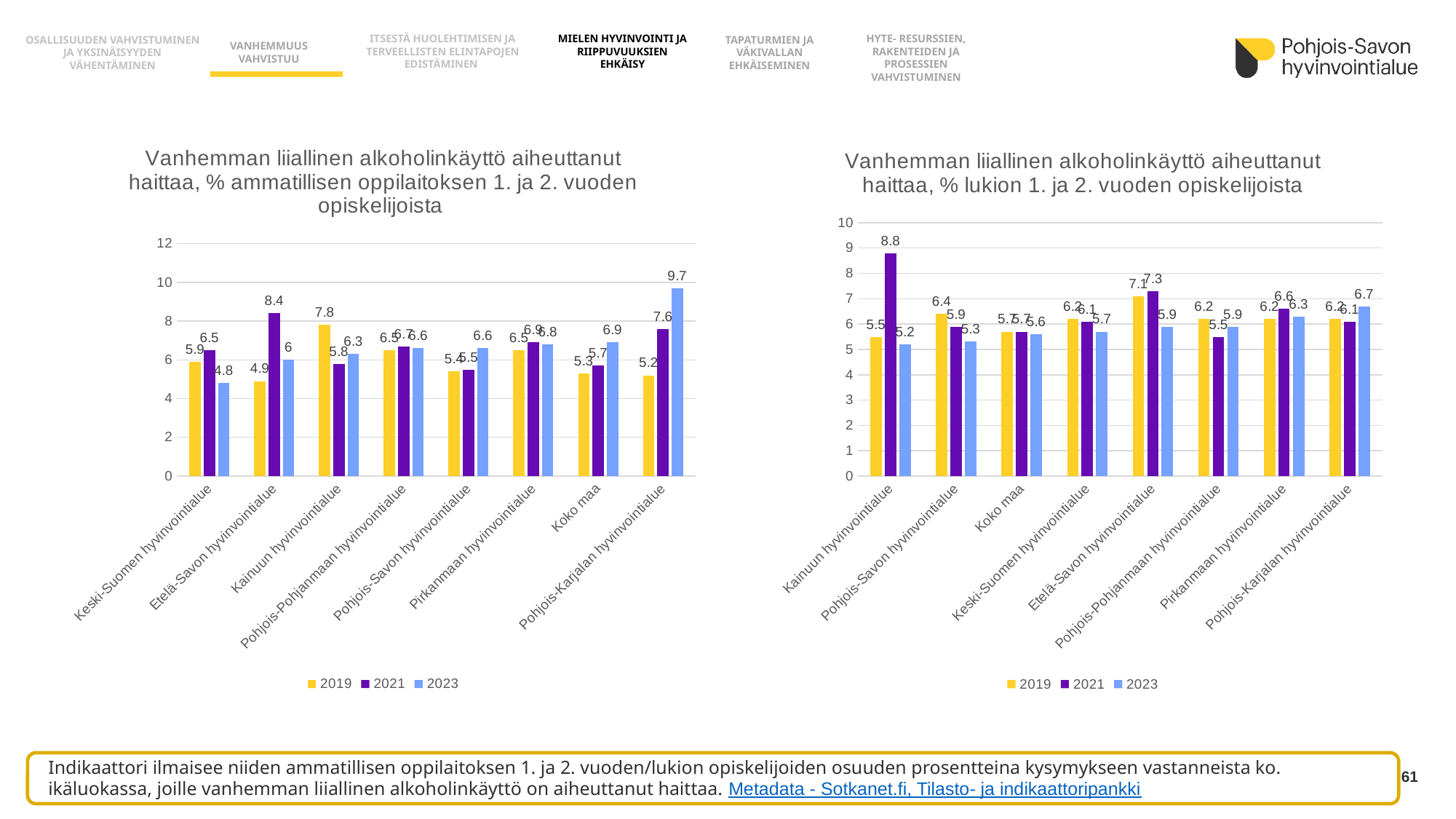
In the right chart (lukion), what is the 2021 value for Kainuun hyvinvointialue? 8.8 In the left chart (ammatillisen oppilaitoksen), how many categories are shown on the x axis? 8 In the left chart (ammatillisen oppilaitoksen), which category has the highest 2019 value? Kainuun hyvinvointialue In the right chart (lukion), how many series does the legend list? 3 In the right chart (lukion), which category has the highest 2021 value? Kainuun hyvinvointialue In the left chart (ammatillisen oppilaitoksen), which category has the lowest 2023 value? Keski-Suomen hyvinvointialue In the right chart (lukion), what is the 2019 value for Pohjois-Savon hyvinvointialue? 6.4 In the left chart (ammatillisen oppilaitoksen), what is the difference between the 2023 and 2019 values for Pohjois-Karjalan hyvinvointialue? 4.5 In the left chart (ammatillisen oppilaitoksen), what is the 2021 value for Etelä-Savon hyvinvointialue? 8.4 In the left chart (ammatillisen oppilaitoksen), what is the 2023 value for Pohjois-Karjalan hyvinvointialue? 9.7 In the right chart (lukion), which is larger for Etelä-Savon hyvinvointialue: the 2019 value or the 2023 value? 2019 What type of chart is the right chart (lukion)? Bar chart